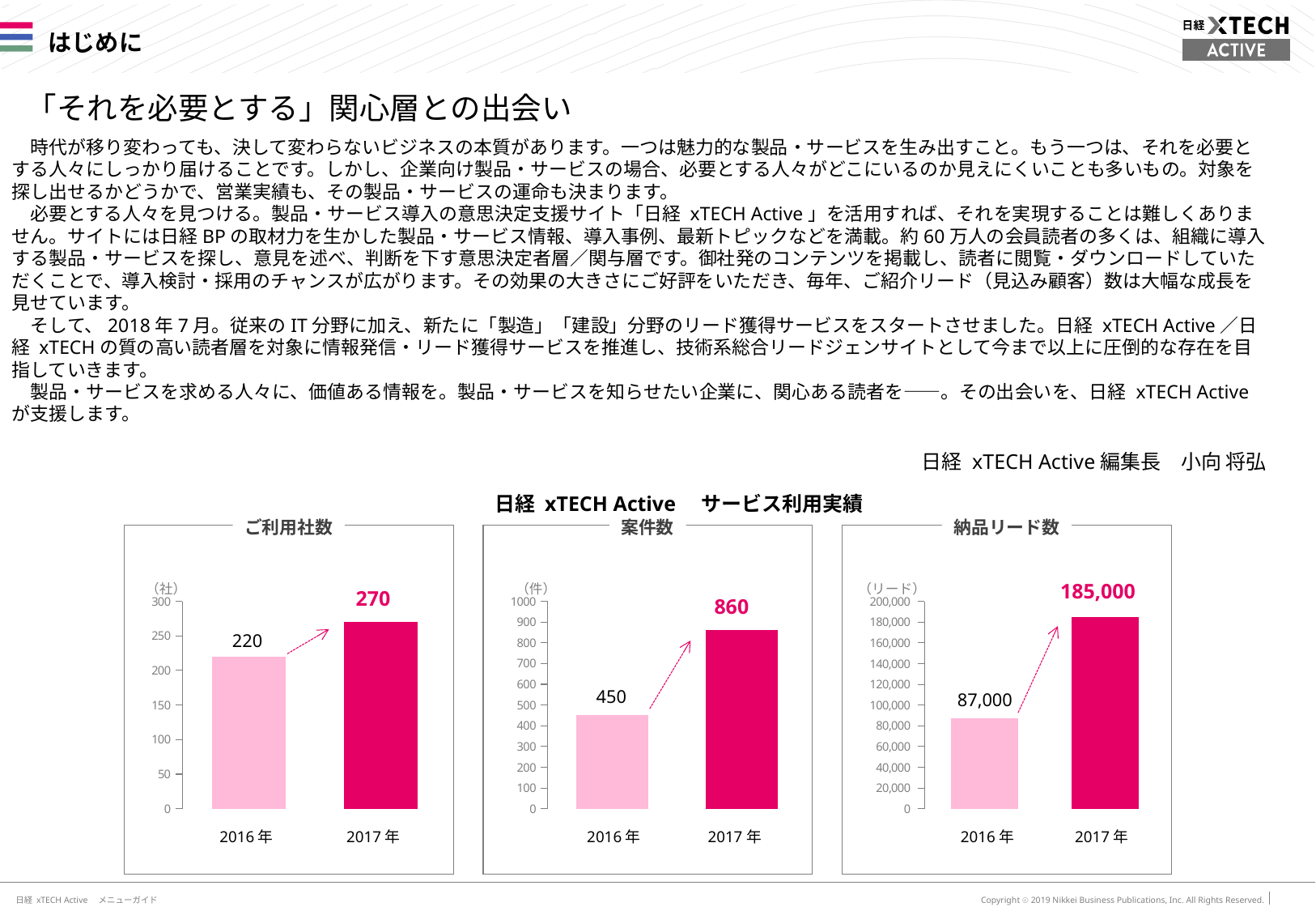
In the 案件数 chart, what is the value for 2016年? 450 In the 納品リード数 chart, what is the value for 2017年? 185,000 In the 納品リード数 chart, what is the value for 2016年? 87,000 In the ご利用社数 chart, what is the difference between the 2017年 and 2016年 values? 50 In the 案件数 chart, what is the value for 2017年? 860 In the 納品リード数 chart, what is the difference between the 2017年 and 2016年 values? 98,000 How many categories are shown on the x axis of the ご利用社数 chart? 2 In the ご利用社数 chart, what is the value for 2017年? 270 In the 案件数 chart, which year has the higher value, 2016年 or 2017年? 2017年 In the 案件数 chart, what is the difference between the 2017年 and 2016年 values? 410 In the ご利用社数 chart, what is the value for 2016年? 220 What kind of chart is the 納品リード数 chart? bar chart